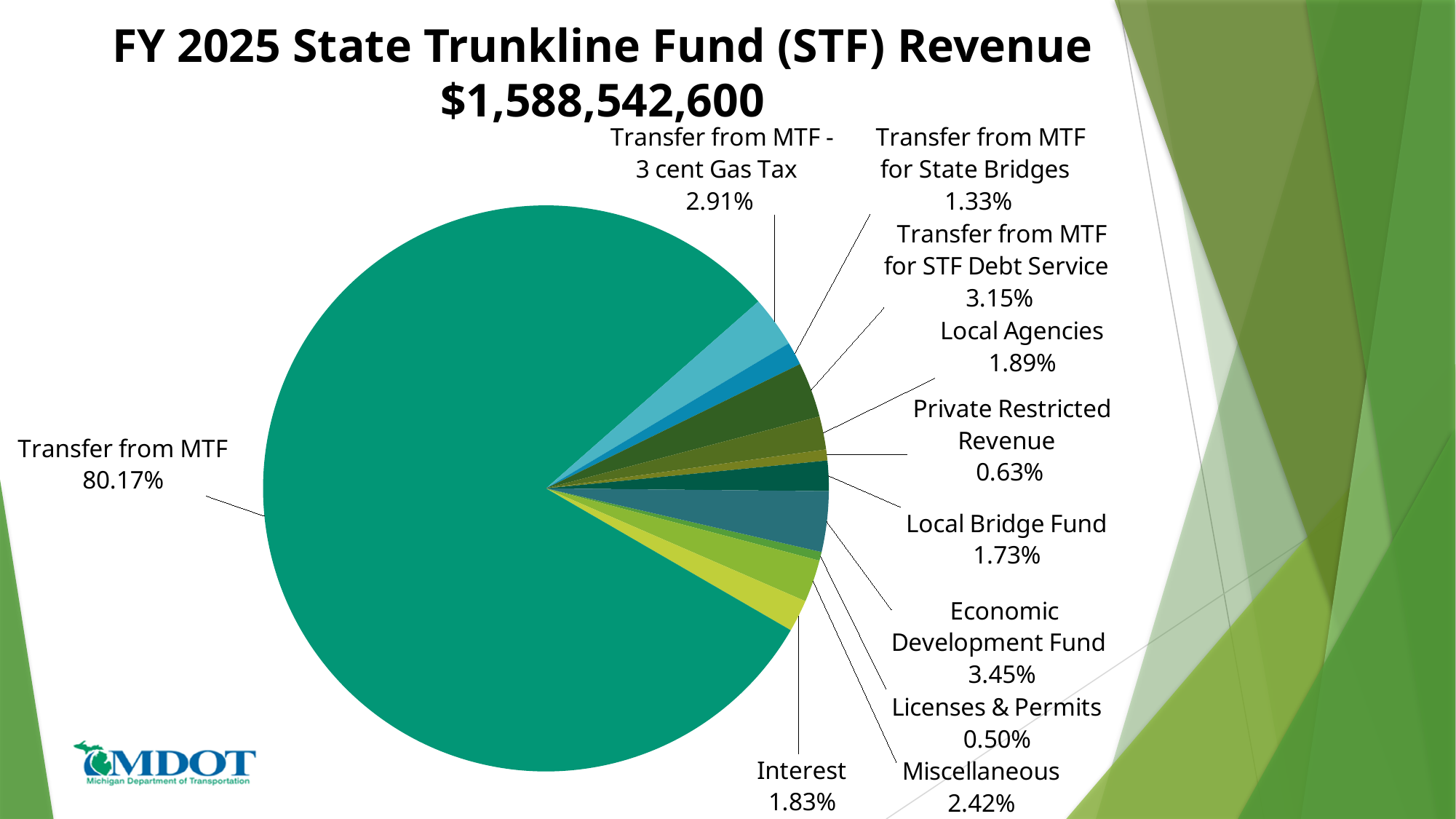
What share of FY 2025 STF revenue comes from Transfer from MTF? 80.17% Which revenue source has the largest share of the pie? Transfer from MTF Which revenue source has the smallest share of the pie? Licenses & Permits What percentage of revenue is attributed to the Economic Development Fund? 3.45% What share of revenue comes from Transfer from MTF for STF Debt Service? 3.15% What is the difference in percentage points between Transfer from MTF - 3 cent Gas Tax and Transfer from MTF for State Bridges? 1.58 How many revenue categories are shown in the pie chart? 11 What is the difference in percentage points between Miscellaneous and Interest? 0.59 What percentage of revenue comes from Licenses & Permits? 0.50% Which is larger: the share for Local Agencies or the share for Local Bridge Fund? Local Agencies What type of chart is shown on the slide? pie chart What total revenue amount is shown in the chart title? $1,588,542,600